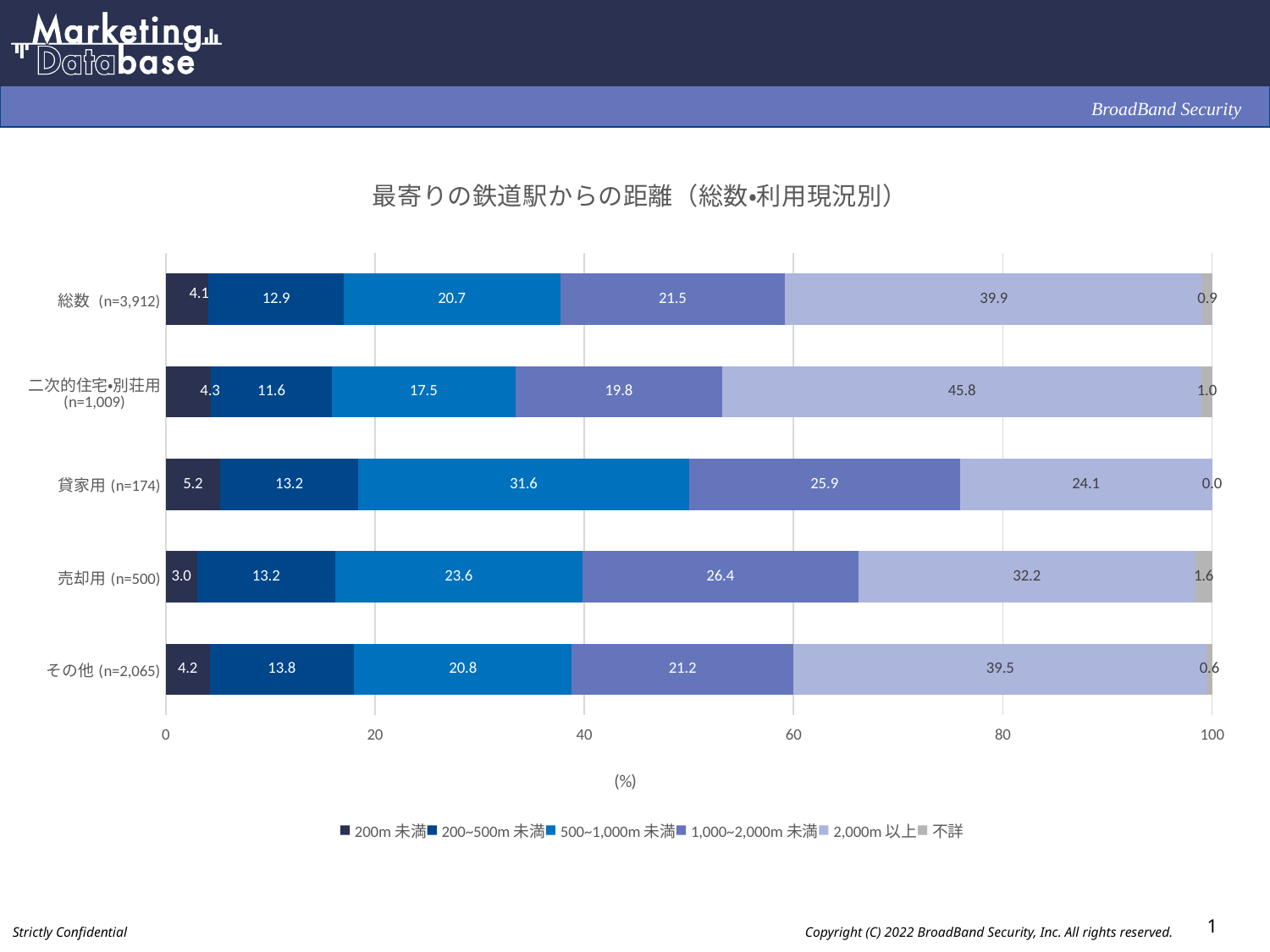
What is the value of 500~1,000m 未満 for 貸家用 (n=174)? 31.6 How many categories are shown on the y axis? 5 What is the title of the chart? 最寄りの鉄道駅からの距離（総数•利用現況別） What is the value of 2,000m 以上 for 二次的住宅•別荘用 (n=1,009)? 45.8 How many series does the legend list? 6 What is the value of 200m 未満 for 売却用 (n=500)? 3.0 What is the difference between the 500~1,000m 未満 values for 貸家用 (n=174) and 総数 (n=3,912)? 10.9 Which is larger: the 1,000~2,000m 未満 value for 売却用 (n=500) or for その他 (n=2,065)? 売却用 (n=500) What type of chart is shown on the slide? Stacked bar chart What is the value of 1,000~2,000m 未満 for 総数 (n=3,912)? 21.5 Which category has the highest value for 2,000m 以上? 二次的住宅•別荘用 (n=1,009) Which category has the lowest value for 200m 未満? 売却用 (n=500)